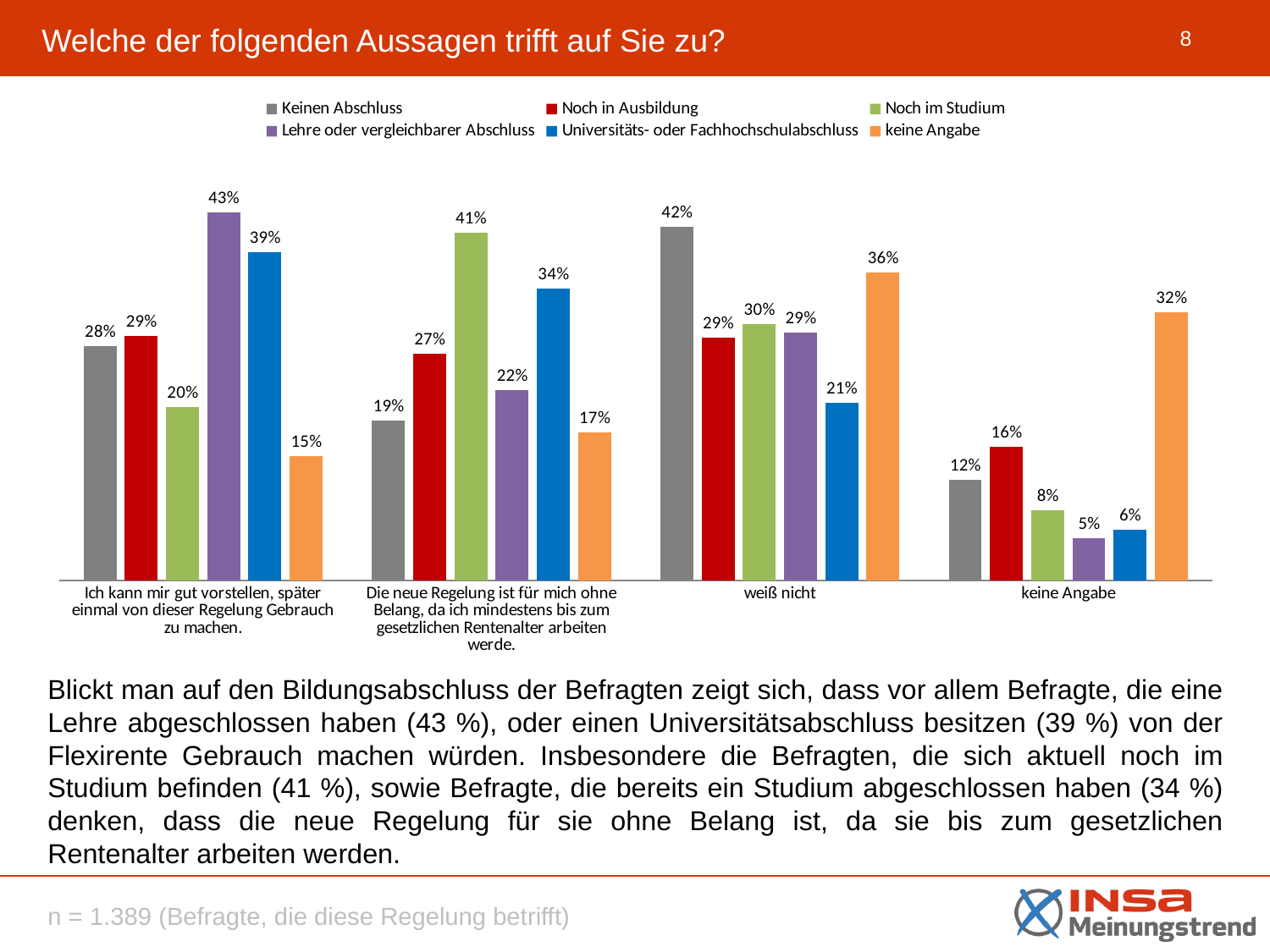
How many series does the legend list? 6 In the category "Ich kann mir gut vorstellen, später einmal von dieser Regelung Gebrauch zu machen.", which is larger: "Noch im Studium" or "Universitäts- oder Fachhochschulabschluss"? Universitäts- oder Fachhochschulabschluss What is the value for "Lehre oder vergleichbarer Abschluss" in the category "Ich kann mir gut vorstellen, später einmal von dieser Regelung Gebrauch zu machen."? 43% Which series has the lowest value in the category "keine Angabe"? Lehre oder vergleichbarer Abschluss What is the difference between "Universitäts- oder Fachhochschulabschluss" (34%) and "Noch im Studium" (41%) in the category "Die neue Regelung ist für mich ohne Belang..."? 7% What is the value for "Keinen Abschluss" in the category "weiß nicht"? 42% How many categories are shown on the x axis? 4 What is the value for "keine Angabe" (series) in the category "keine Angabe"? 32% What colour are the bars for the series "Noch in Ausbildung"? red What kind of chart is shown on the slide? bar chart Which series has the highest value in the category "weiß nicht"? Keinen Abschluss What is the value for "Noch im Studium" in the category "Die neue Regelung ist für mich ohne Belang, da ich mindestens bis zum gesetzlichen Rentenalter arbeiten werde."? 41%